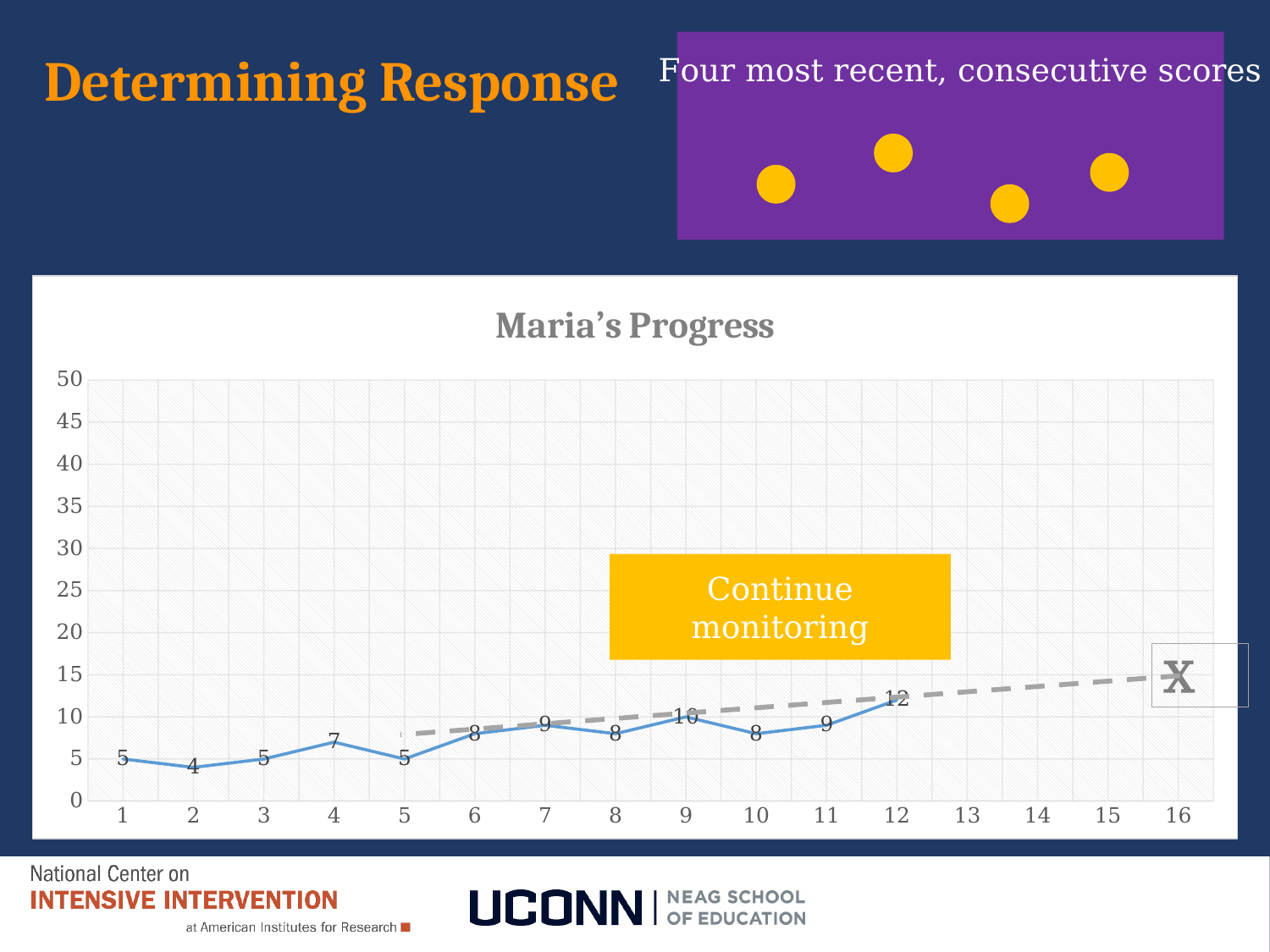
How many data points are plotted on Maria's progress line? 12 At which point is Maria's score the lowest? 2 Which is larger, Maria's score at point 4 or at point 5? point 4 What is the difference between Maria's score at point 12 and her score at point 1? 7 What is Maria's score at point 2? 4 At which point is Maria's score the highest? 12 Overall, do Maria's scores rise or fall from point 1 to point 12? rise Is Maria's score at point 12 greater or less than 15? less What kind of chart is shown on the slide? line chart What is Maria's score at point 9? 10 What is the title of the chart? Maria's Progress What is Maria's score at point 12? 12